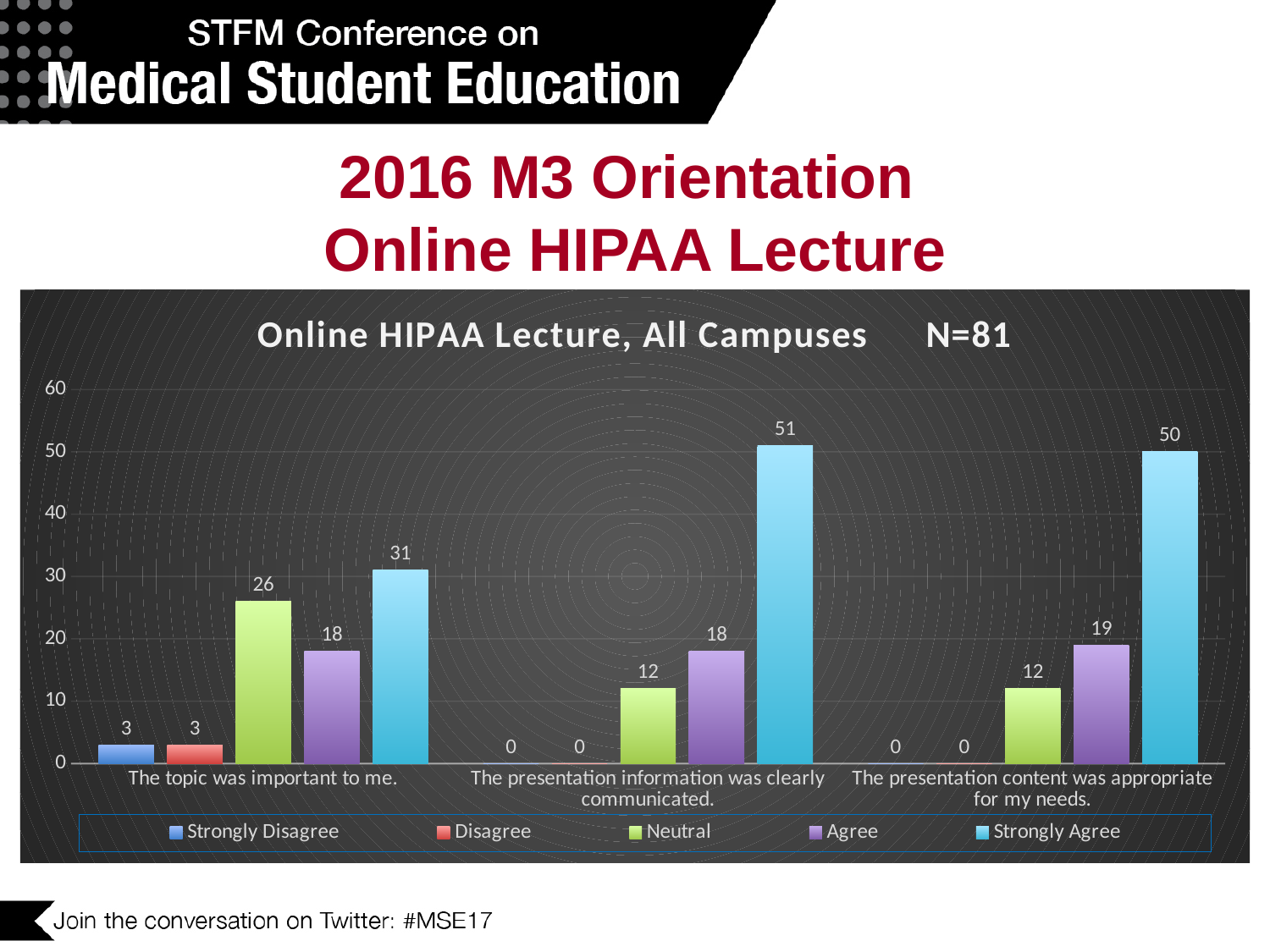
How many series does the legend list? 5 What is the difference between the Strongly Agree and Agree values for "The topic was important to me."? 13 How many categories are shown on the x axis? 3 What is the value for Disagree for "The presentation information was clearly communicated."? 0 Which is larger for "The presentation content was appropriate for my needs.": Neutral or Agree? Agree What is the value for Neutral for "The topic was important to me."? 26 What kind of chart is shown on the slide? Bar chart Which category has the highest Strongly Agree value? The presentation information was clearly communicated. What is the value for Strongly Agree for "The presentation information was clearly communicated."? 51 Which category has the lowest Strongly Agree value? The topic was important to me. What is the value for Agree for "The presentation content was appropriate for my needs."? 19 What is the title of the chart? Online HIPAA Lecture, All Campuses N=81